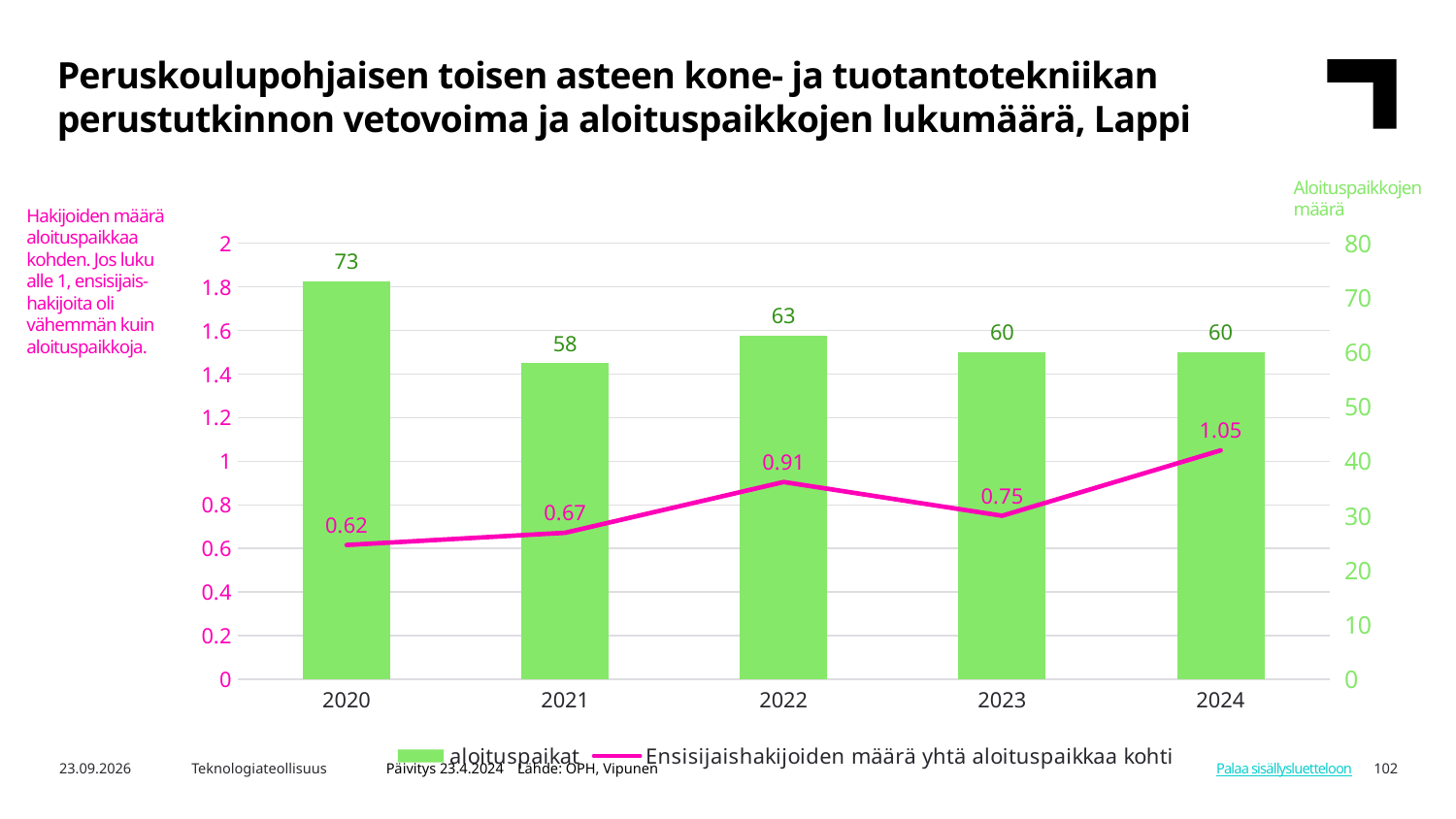
What is the value of Ensisijaishakijoiden määrä yhtä aloituspaikkaa kohti for 2024? 1.05 Which year has the lowest value of aloituspaikat? 2021 Which year has the lowest value of Ensisijaishakijoiden määrä yhtä aloituspaikkaa kohti? 2020 What colour are the aloituspaikat bars? green Which is larger, the Ensisijaishakijoiden määrä yhtä aloituspaikkaa kohti value for 2022 or for 2023? 2022 What is the value of Ensisijaishakijoiden määrä yhtä aloituspaikkaa kohti for 2022? 0.91 How many series does the legend list? 2 Which year has the highest value of aloituspaikat? 2020 How many years are shown on the x axis? 5 What is the value of aloituspaikat for 2020? 73 Does the Ensisijaishakijoiden määrä yhtä aloituspaikkaa kohti value rise or fall from 2023 to 2024? rise What is the difference between the aloituspaikat values for 2020 and 2021? 15